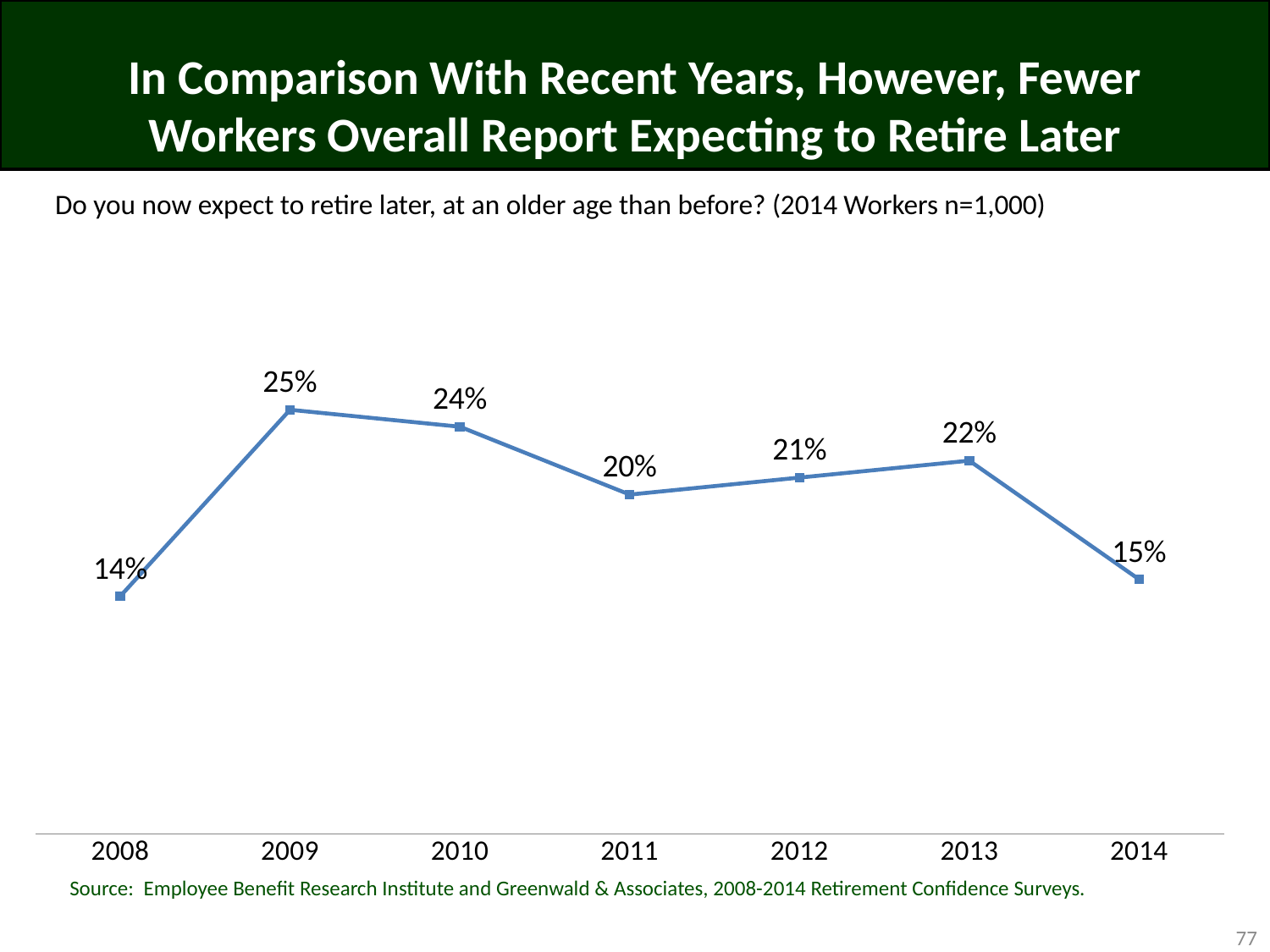
Which is larger, the value for 2010 or the value for 2012? 2010 Does the value rise or fall from 2013 to 2014? Fall What percentage of workers reported expecting to retire later in 2009? 25% What survey question is the chart based on, as stated on the slide? Do you now expect to retire later, at an older age than before? What is the difference between the 2013 value and the 2014 value? 7 percentage points What is the difference between the 2009 value and the 2008 value? 11 percentage points Which year has the lowest value on the chart? 2008 What kind of chart is shown on the slide? Line chart How many years are plotted on the chart? 7 What is the value shown for 2011? 20% What is the value shown for 2014? 15% Which year has the highest value on the chart? 2009